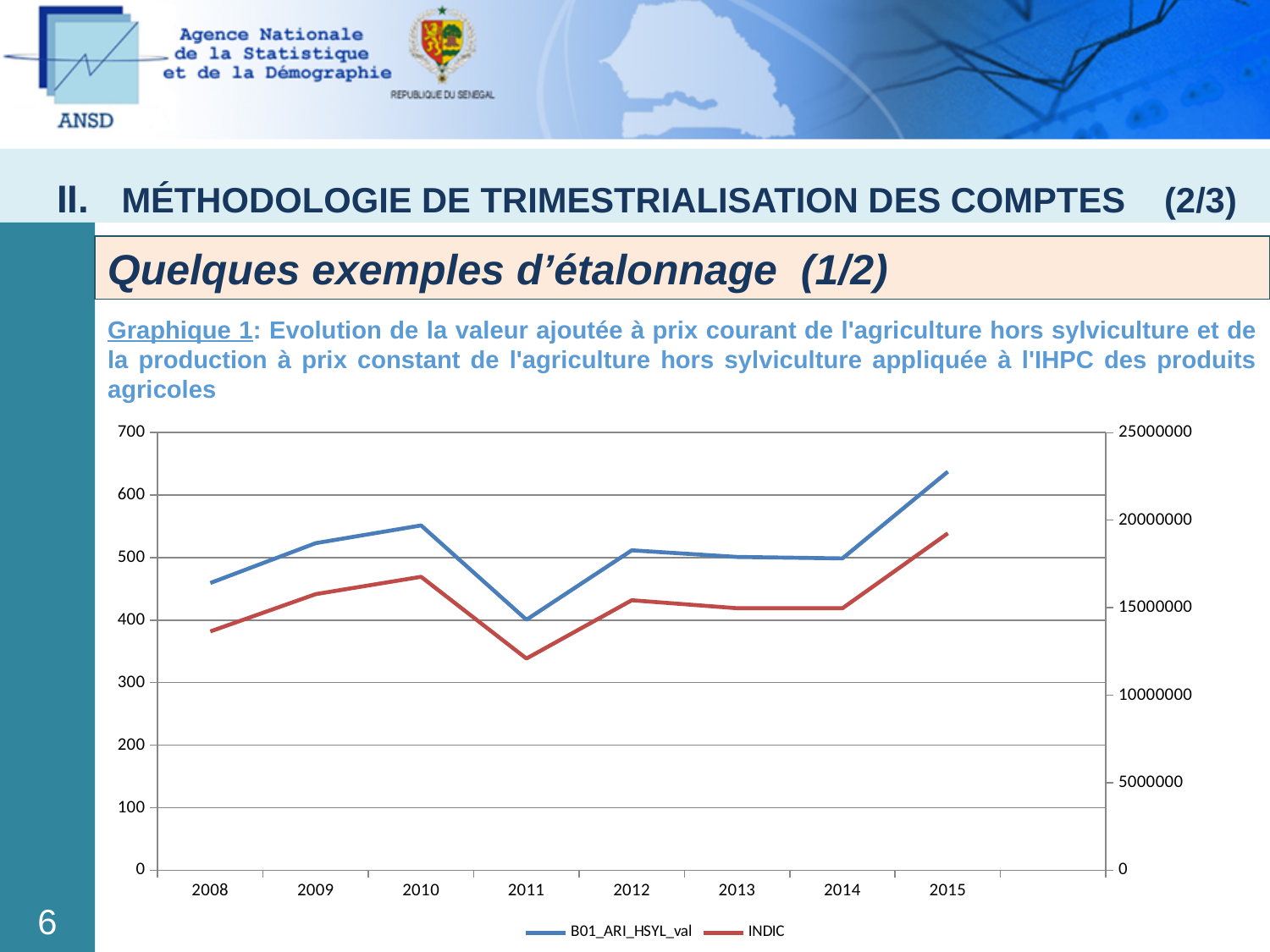
How many series does the legend list? 2 On the left axis, is the value for B01_ARI_HSYL_val in 2010 greater or less than 500? greater In which year does the INDIC series reach its highest value? 2015 On the left axis, is the value for B01_ARI_HSYL_val in 2015 greater or less than 600? greater What colour is the line for the INDIC series? red Does the B01_ARI_HSYL_val series rise or fall between 2010 and 2011? fall On the left axis, is the value for B01_ARI_HSYL_val in 2011 greater or less than 500? less What kind of chart is shown on the slide? line chart In which year does the B01_ARI_HSYL_val series reach its lowest value? 2011 In which year does the INDIC series reach its lowest value? 2011 In which year does the B01_ARI_HSYL_val series reach its highest value? 2015 How many years are shown on the x axis of the chart? 8